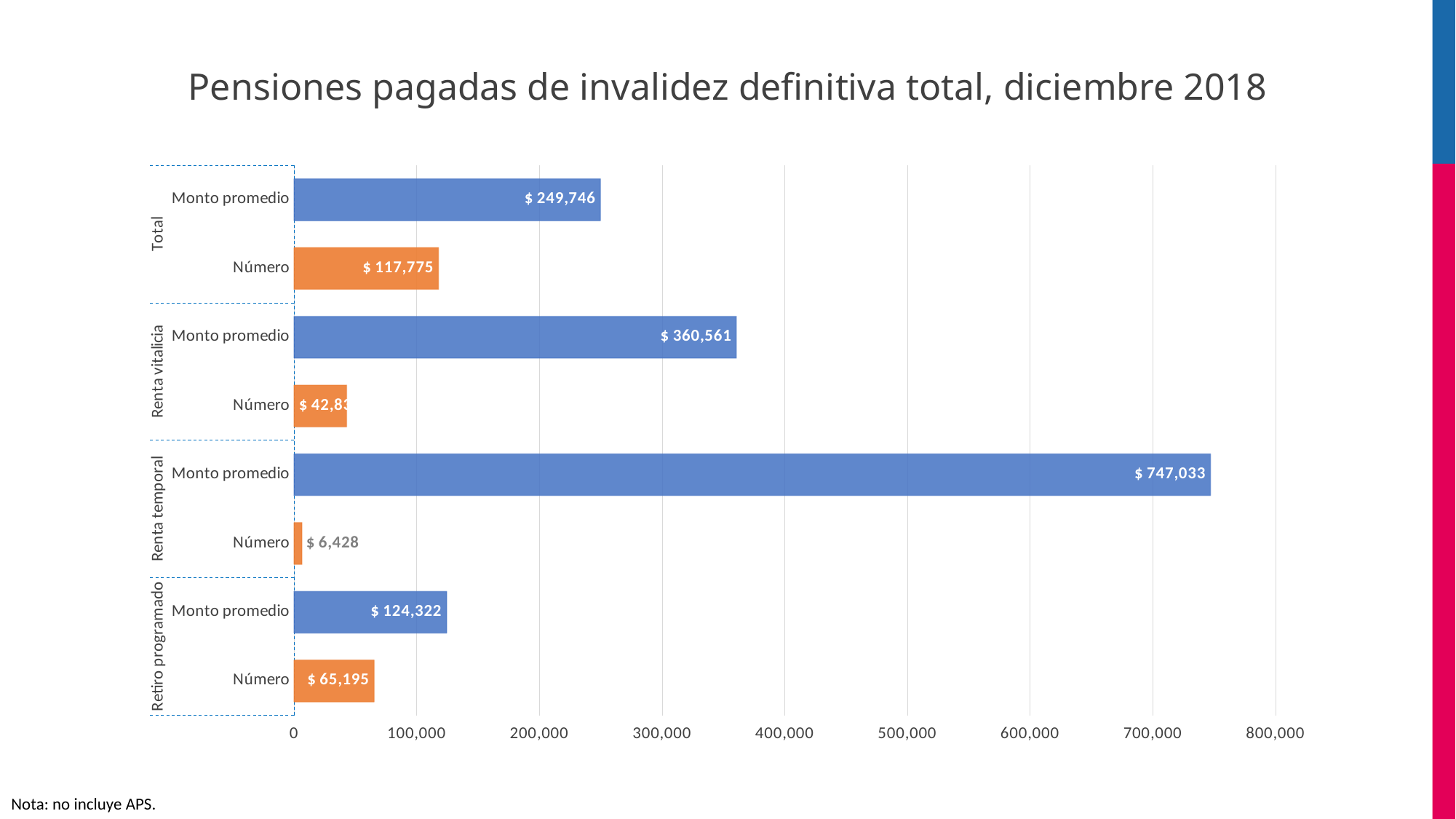
How many bars are plotted on the chart? 8 What is the Número value for Renta temporal? $ 6,428 Which category has the highest Monto promedio? Renta temporal Is the Monto promedio for Renta vitalicia greater or less than 300,000? greater Which is larger: the Número for Retiro programado or the Número for Total? Número for Total What is the difference between the Monto promedio for Renta vitalicia and the Monto promedio for Total? $ 110,815 What is the Monto promedio value for Renta temporal? $ 747,033 What is the Monto promedio value for Retiro programado? $ 124,322 What is the title of the chart? Pensiones pagadas de invalidez definitiva total, diciembre 2018 What is the Número value for Total? $ 117,775 What kind of chart is shown on the slide? Bar chart Which bar on the chart has the smallest value? Número for Renta temporal